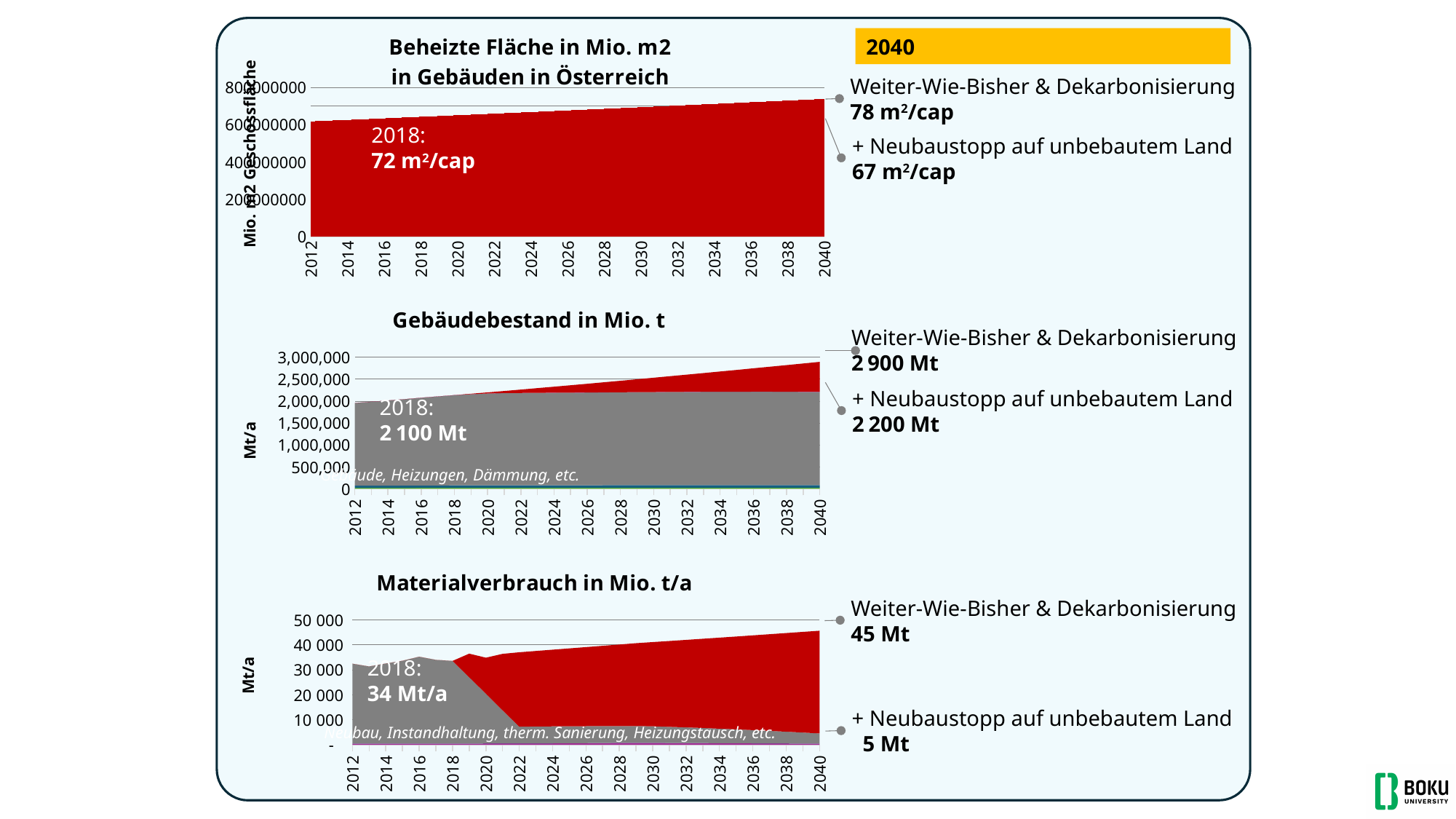
On the 'Beheizte Fläche' chart, what is the difference between the two 2040 scenario values (78 m²/cap and 67 m²/cap)? 11 m²/cap On the 'Gebäudebestand in Mio. t' chart, what is the difference between the 2040 values of the two scenarios (2 900 Mt and 2 200 Mt)? 700 Mt On the 'Gebäudebestand in Mio. t' chart, does the top of the red area rise or fall from 2020 to 2040? rise On the 'Beheizte Fläche in Mio. m2 in Gebäuden in Österreich' chart, what 2040 value is given for the 'Weiter-Wie-Bisher & Dekarbonisierung' scenario? 78 m²/cap On the 'Materialverbrauch in Mio. t/a' chart, what value is annotated for 2018? 34 Mt/a On the 'Gebäudebestand in Mio. t' chart, what value is annotated for 2018? 2 100 Mt On the 'Materialverbrauch in Mio. t/a' chart, is the top of the red area in 2040 greater or less than 40 000? greater On the 'Materialverbrauch in Mio. t/a' chart, which 2040 scenario has the larger value: 'Weiter-Wie-Bisher & Dekarbonisierung' or '+ Neubaustopp auf unbebautem Land'? Weiter-Wie-Bisher & Dekarbonisierung On the 'Beheizte Fläche in Mio. m2 in Gebäuden in Österreich' chart, what value is annotated for 2018? 72 m²/cap On the 'Beheizte Fläche in Mio. m2 in Gebäuden in Österreich' chart, what 2040 value is given for the '+ Neubaustopp auf unbebautem Land' scenario? 67 m²/cap On the 'Gebäudebestand in Mio. t' chart, what 2040 value is given for 'Weiter-Wie-Bisher & Dekarbonisierung'? 2 900 Mt How many charts are shown on the slide? 3